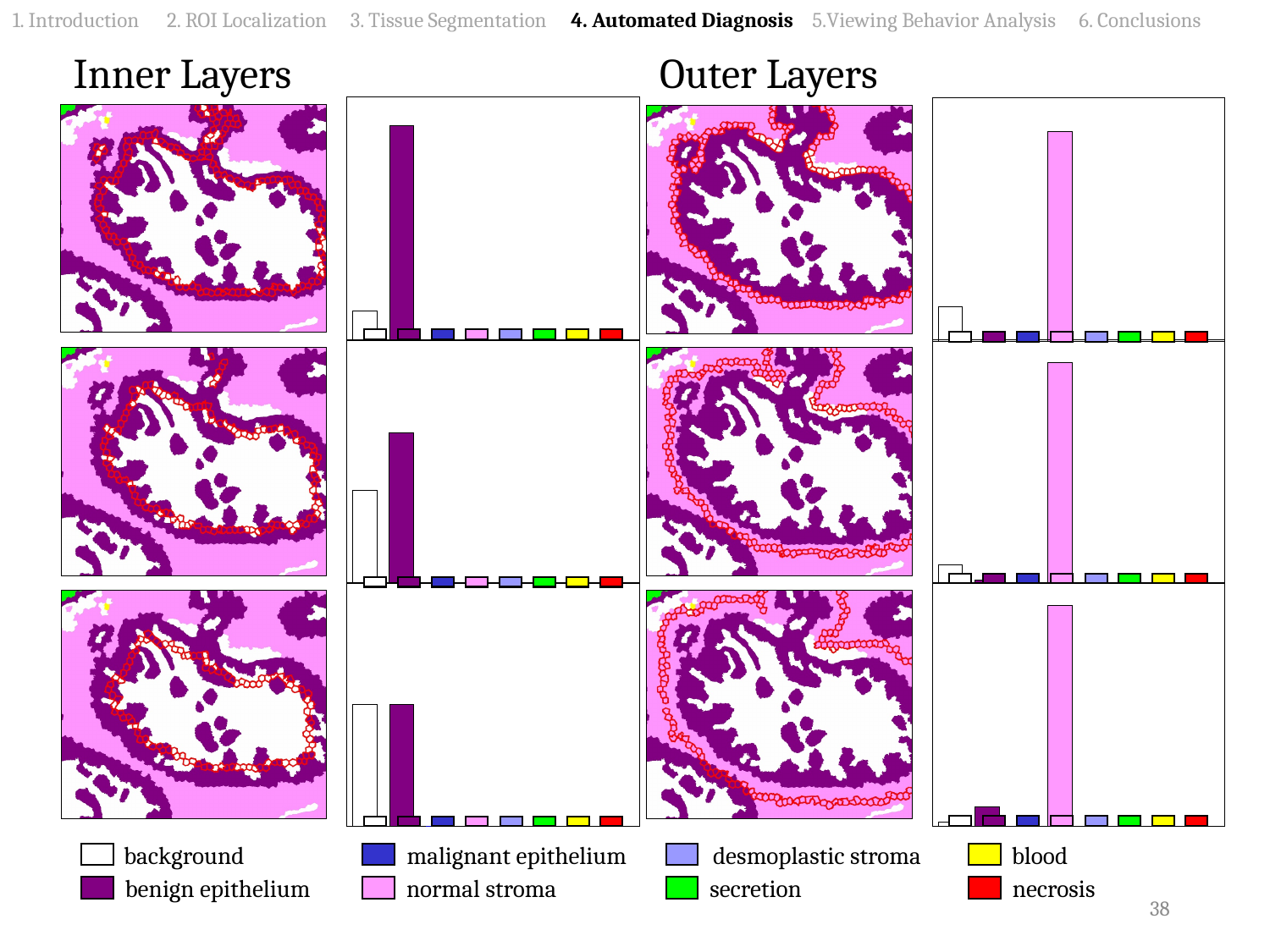
How many tissue classes does the legend at the bottom of the slide list? 8 In the top Inner Layers bar chart, which tissue class has the tallest bar? benign epithelium How many tissue classes (bars) are shown in each bar chart? 8 In the bottom Outer Layers bar chart, is the bar for benign epithelium or the bar for normal stroma taller? normal stroma In the middle Inner Layers bar chart, is the bar for benign epithelium or the bar for background taller? benign epithelium In the middle Outer Layers bar chart, which tissue class has the tallest bar? normal stroma How many bar charts are shown on the slide in total? 6 In the bottom Outer Layers bar chart, which tissue class has the tallest bar? normal stroma According to the legend, which colour represents normal stroma? pink In the top Inner Layers bar chart, is the bar for background or the bar for benign epithelium taller? benign epithelium What kind of chart is used in the Inner Layers and Outer Layers panels? bar chart